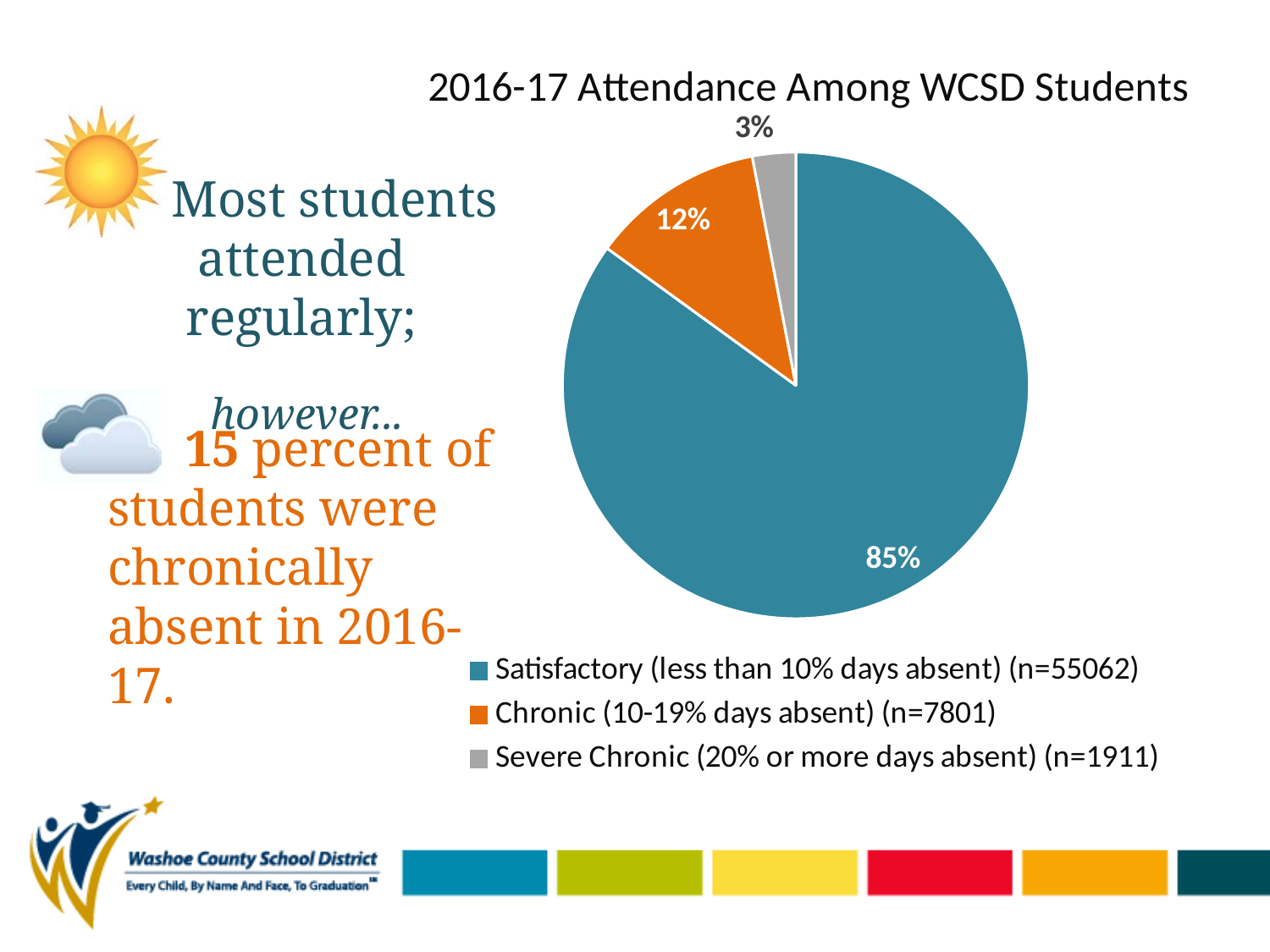
What percentage of students had Satisfactory attendance (less than 10% days absent)? 85% What kind of chart is shown on the slide? pie chart What percentage of students were Severe Chronic (20% or more days absent)? 3% Which category has the smallest share of the pie? Severe Chronic (20% or more days absent) Which category has the largest share of the pie? Satisfactory (less than 10% days absent) What percentage of students were Chronic (10-19% days absent)? 12% How many categories does the pie chart show? 3 What is the combined percentage of the Chronic and Severe Chronic slices? 15% What is the title of the chart? 2016-17 Attendance Among WCSD Students What is the n value shown in the legend for the Chronic category? 7801 Which is larger, the Chronic slice or the Severe Chronic slice? Chronic What is the difference in percentage points between the Chronic and Severe Chronic slices? 9